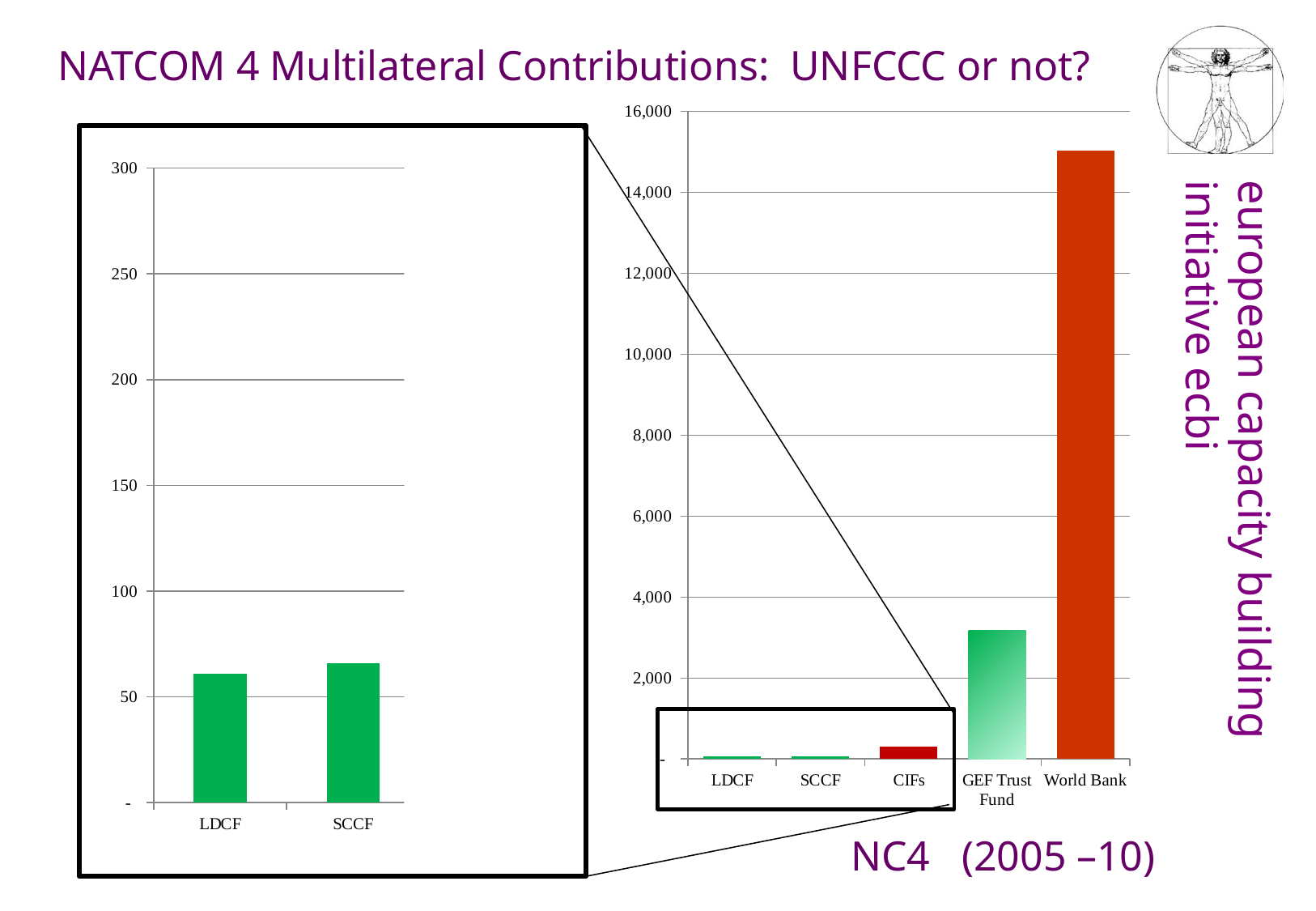
On the right-hand chart, is the value for GEF Trust Fund greater or less than 4,000? less On the right-hand chart, which category has the highest value? World Bank What kind of chart is the right-hand chart? bar chart On the left-hand (zoomed-in) chart, is the value for LDCF greater or less than 100? less On the right-hand chart, which is larger, the value for CIFs or the value for GEF Trust Fund? GEF Trust Fund On the right-hand chart, which is larger, the value for World Bank or the value for GEF Trust Fund? World Bank On the right-hand chart, is the value for World Bank greater or less than 14,000? greater How many categories are shown on the right-hand chart? 5 How many categories are shown on the left-hand (zoomed-in) chart? 2